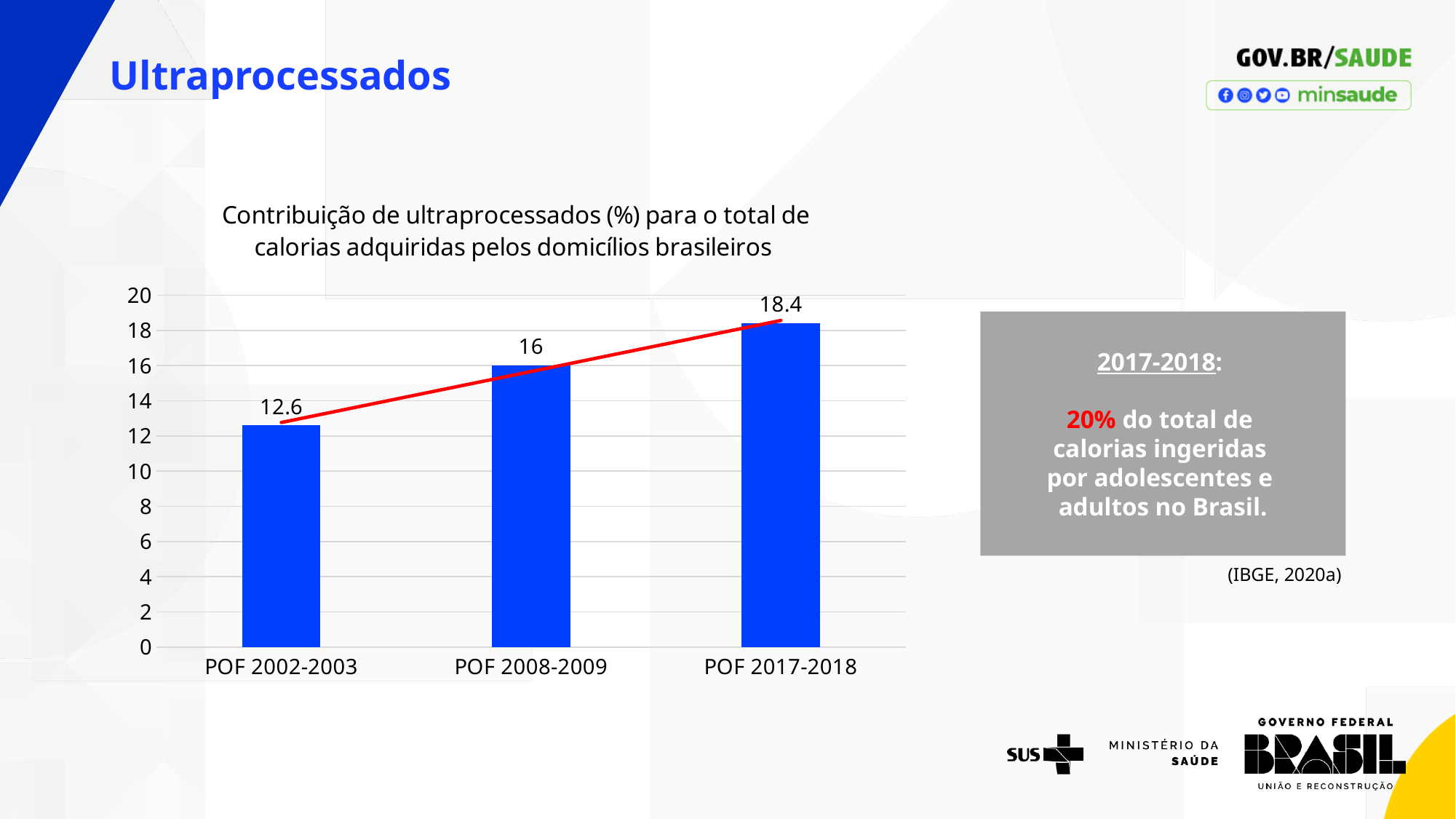
What is the difference between the values for POF 2008-2009 and POF 2002-2003? 3.4 How many categories are shown on the x axis? 3 What is the value for POF 2002-2003? 12.6 What kind of chart is shown on the slide? Bar chart What is the value for POF 2008-2009? 16 What is the difference between the values for POF 2017-2018 and POF 2002-2003? 5.8 What is the value for POF 2017-2018? 18.4 What is the title of the chart? Contribuição de ultraprocessados (%) para o total de calorias adquiridas pelos domicílios brasileiros Which is larger, the value for POF 2008-2009 or POF 2017-2018? POF 2017-2018 Do the values rise or fall from POF 2002-2003 to POF 2017-2018? Rise Which category has the lowest value? POF 2002-2003 Which category has the highest value? POF 2017-2018